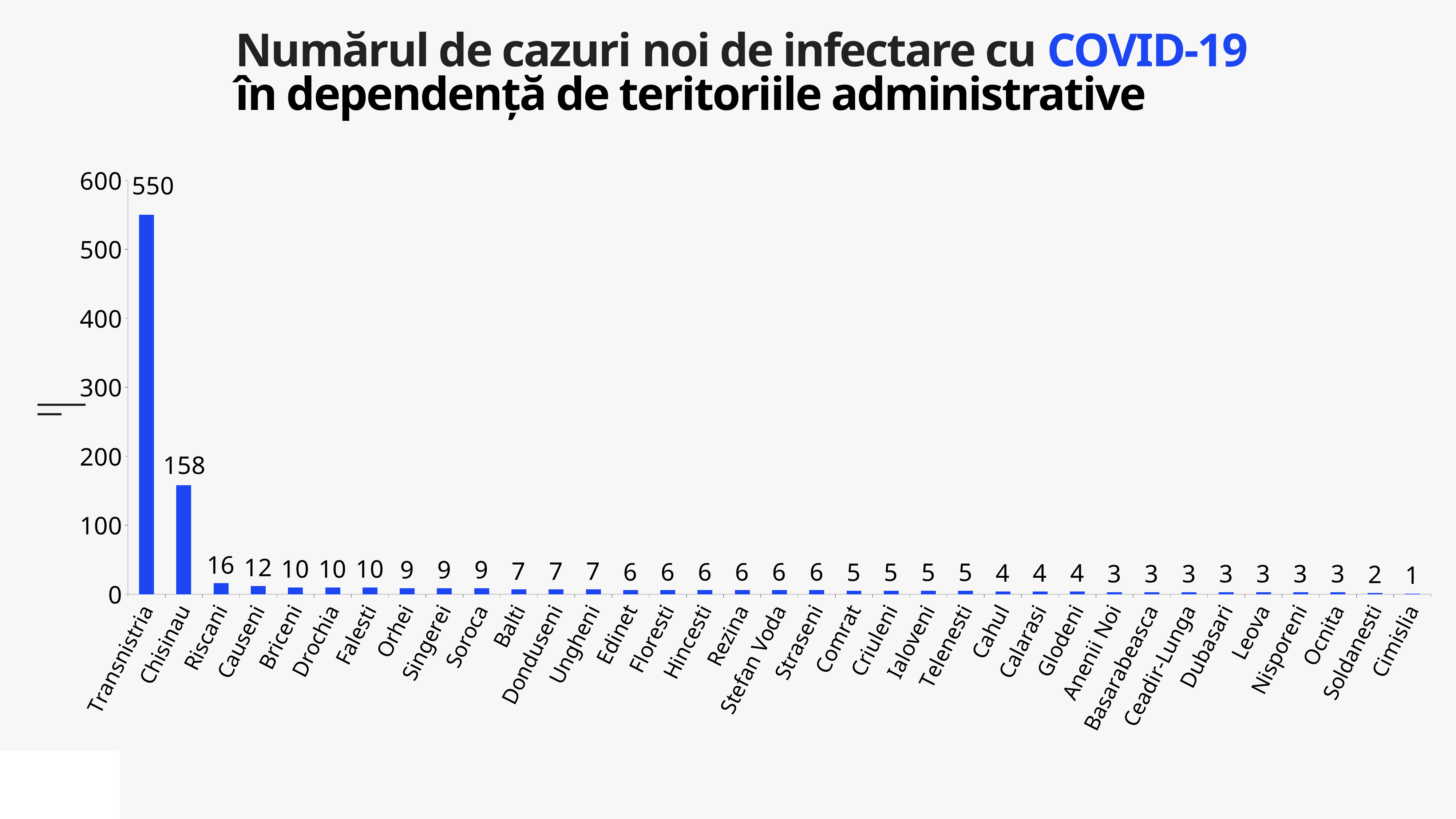
What is the value for Transnistria? 550 Is the value for Transnistria greater or less than 500? greater What is the value for Chisinau? 158 Which category has the highest value? Transnistria Which is larger, the value for Causeni or the value for Orhei? Causeni What is the value for Balti? 7 What kind of chart is shown on the slide? bar chart Do the values rise or fall from left to right along the x axis? fall How many categories are shown on the x axis? 35 What is the value for Riscani? 16 What is the difference between the values for Transnistria and Chisinau? 392 Which category has the lowest value? Cimislia